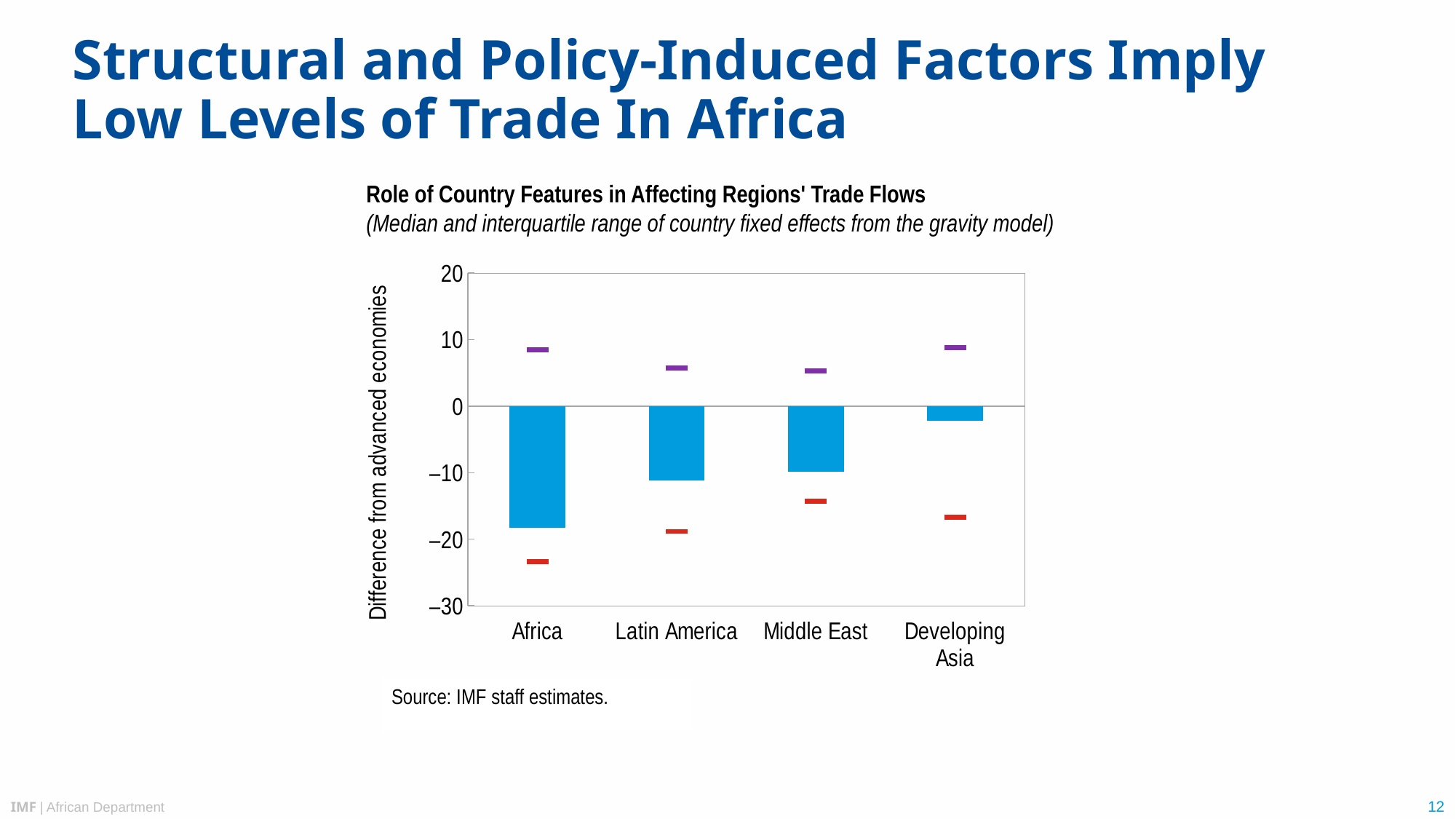
Which region has the lowest (most negative) blue bar? Africa How many regions are shown on the x axis of the chart? 4 Is the red marker for Africa greater or less than -20? less Is the blue bar value for Africa greater or less than -10? less What kind of chart is shown on the slide? bar chart Is the blue bar value for Latin America greater or less than -10? less Which blue bar is more negative, Africa or Middle East? Africa What is the title of the chart? Role of Country Features in Affecting Regions' Trade Flows Which region has the blue bar closest to zero? Developing Asia What is the label on the vertical axis of the chart? Difference from advanced economies